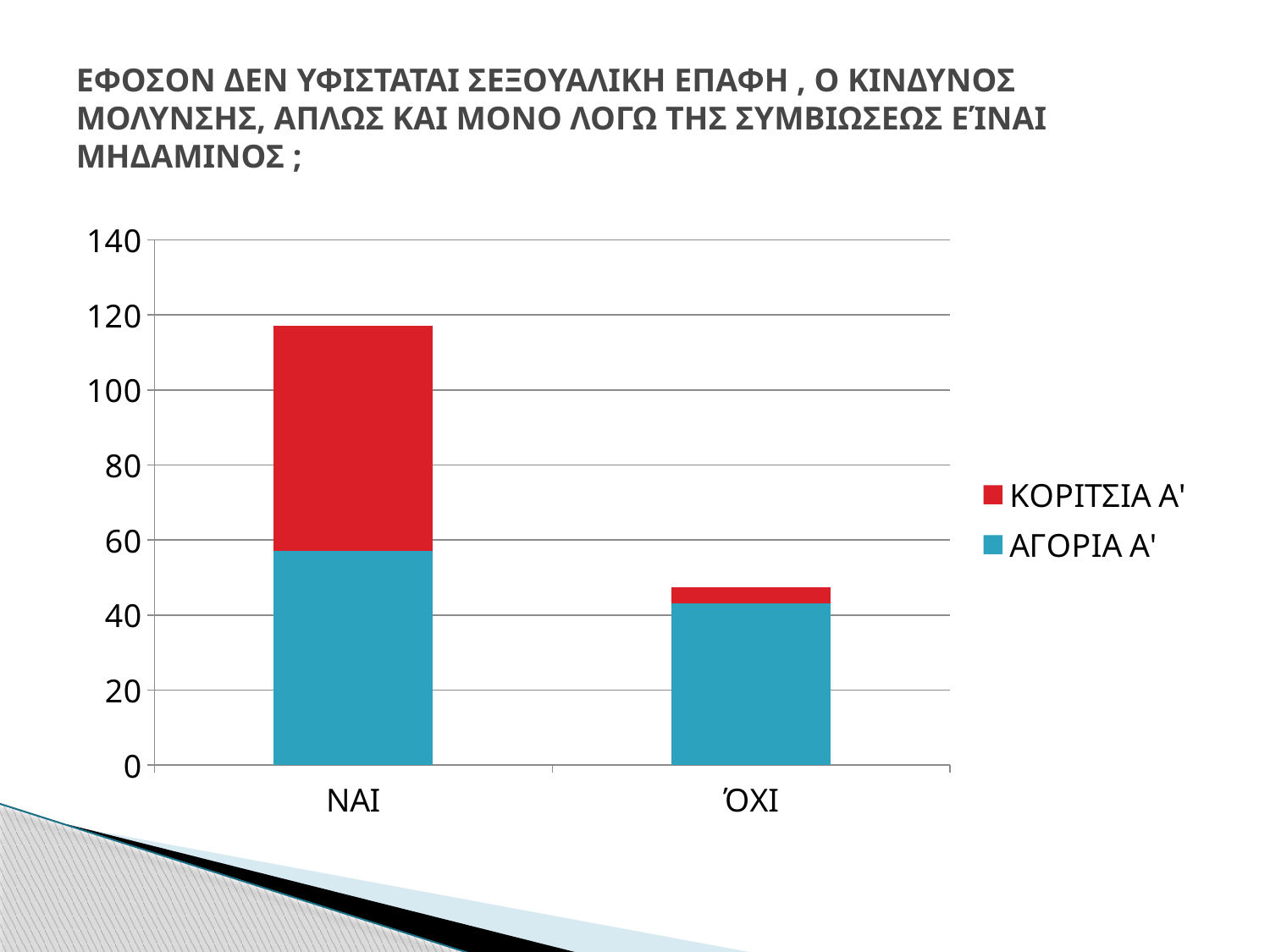
How many series does the chart's legend list? 2 Is the total of the stacked bar for ΌΧΙ greater or less than 60? less Is the ΑΓΟΡΙΑ Α' value for ΝΑΙ greater or less than 40? greater Which category has the larger ΚΟΡΙΤΣΙΑ Α' segment, ΝΑΙ or ΌΧΙ? ΝΑΙ What colour represents the ΚΟΡΙΤΣΙΑ Α' series in the chart? red How many categories are shown on the x axis of the chart? 2 In the ΌΧΙ bar, which series has the larger segment, ΚΟΡΙΤΣΙΑ Α' or ΑΓΟΡΙΑ Α'? ΑΓΟΡΙΑ Α' Is the total of the stacked bar for ΝΑΙ greater or less than 100? greater Which category has the shorter stacked bar? ΌΧΙ What kind of chart is shown on the slide? stacked bar chart Which category has the taller stacked bar, ΝΑΙ or ΌΧΙ? ΝΑΙ